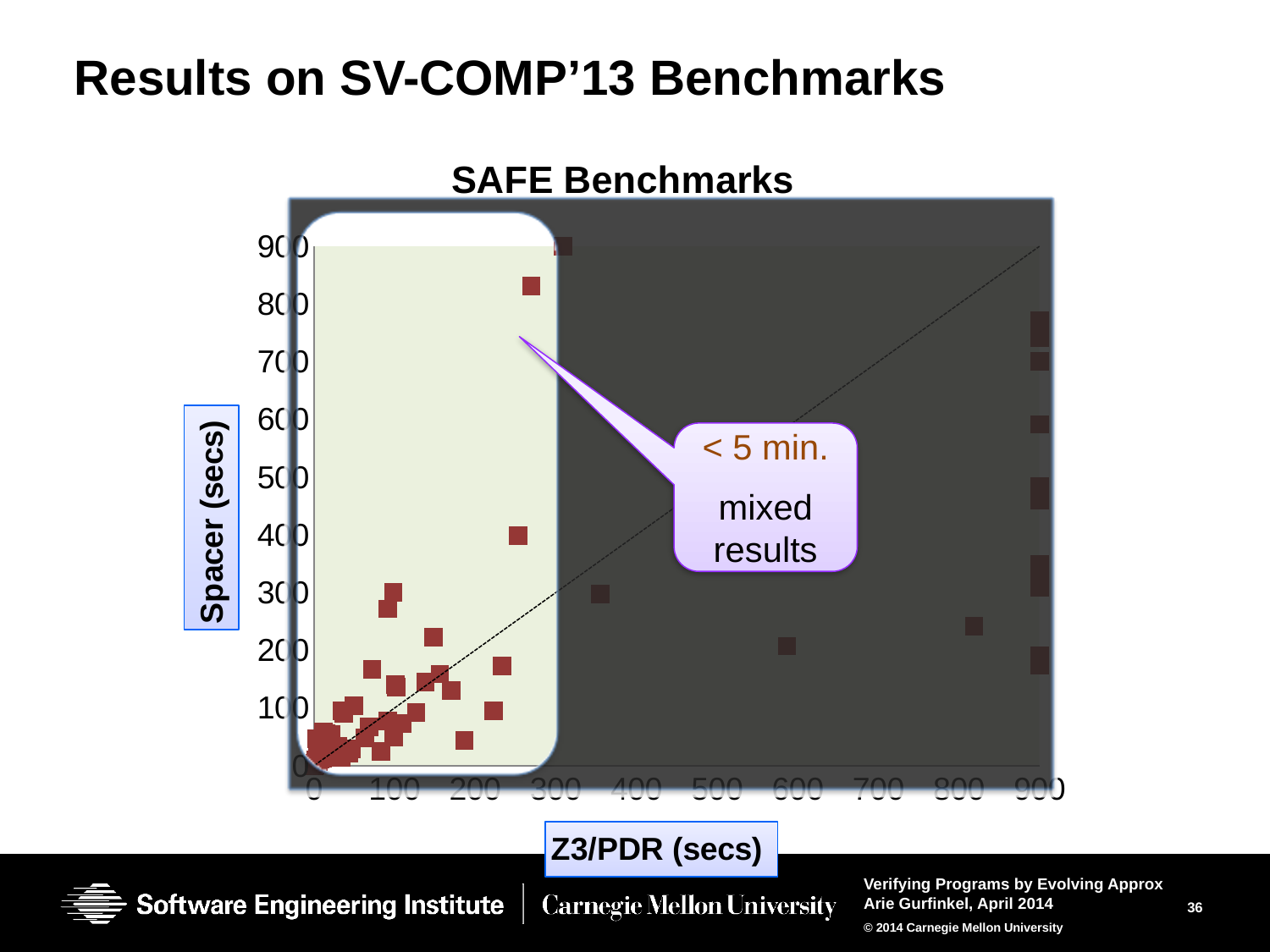
What kind of chart is shown under the title 'SAFE Benchmarks'? scatter plot What is the title of the chart on the slide? SAFE Benchmarks What is the label of the x axis of the chart? Z3/PDR (secs) Is the Spacer (secs) value of the highest plotted point greater or less than 800? greater